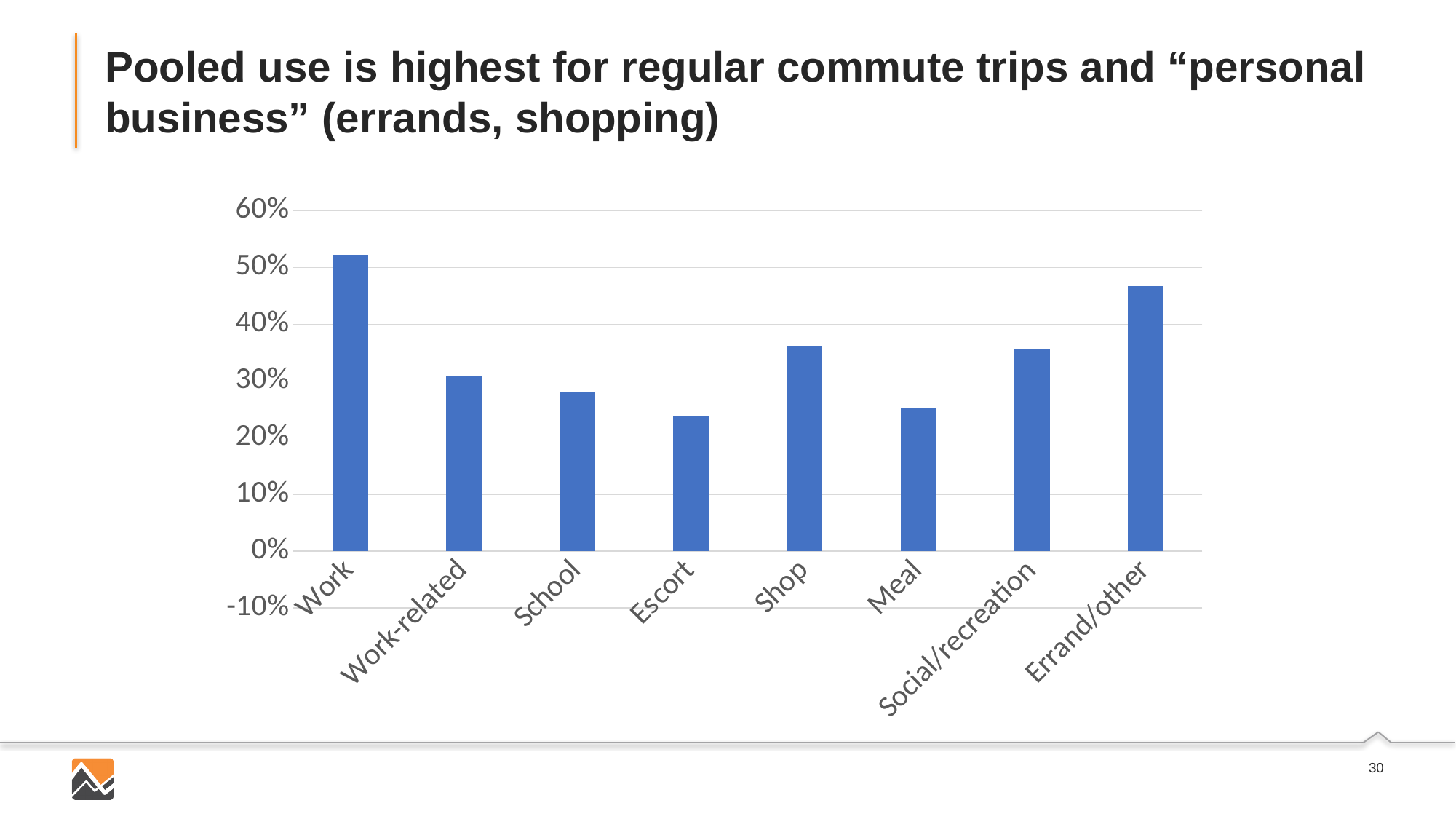
Which is larger, the value for Work-related or the value for Meal? Work-related Which is larger, the value for Work or the value for Errand/other? Work Which is larger, the value for Shop or the value for Escort? Shop Which category has the second-highest bar? Errand/other Is the value for Shop greater or less than 40%? less How many trip-purpose categories are plotted on the chart? 8 Is the value for Errand/other greater or less than 50%? less Is the value for Escort greater or less than 20%? greater Which category has the highest bar? Work What kind of chart is shown on the slide? bar chart